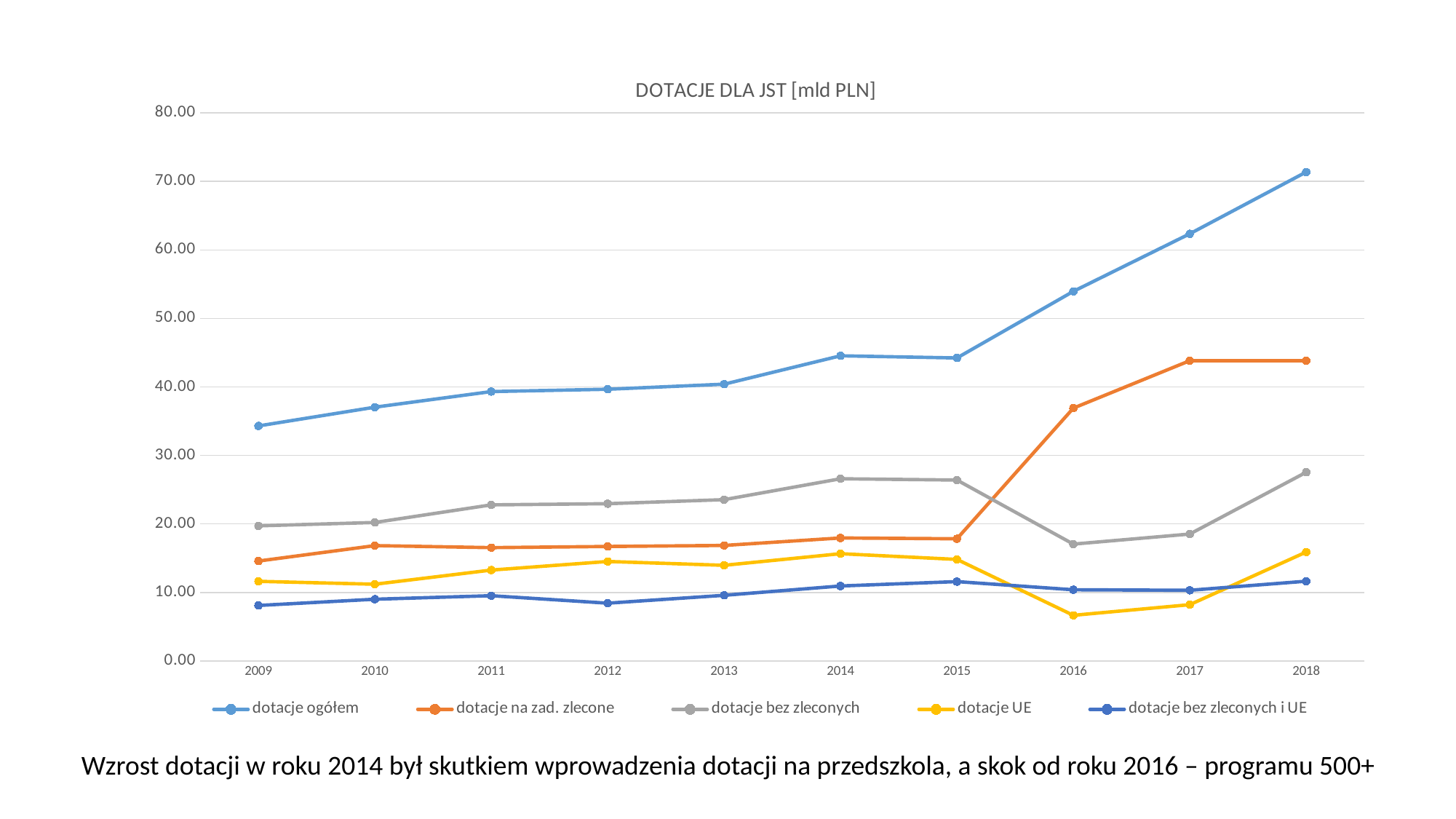
Is the value for 'dotacje UE' in 2016 greater or less than 10.00? less Which colour is used for the 'dotacje UE' series? yellow Does 'dotacje ogółem' generally rise or fall from 2009 to 2018? rise In which year is 'dotacje UE' lowest? 2016 How many years are plotted along the x axis? 10 What is the title of the chart? DOTACJE DLA JST [mld PLN] Is the value for 'dotacje na zad. zlecone' in 2016 greater or less than 30.00? greater What kind of chart is shown on the slide? line chart Is the value for 'dotacje ogółem' in 2018 greater or less than 70.00? greater How many series does the legend list? 5 In 2016, which is larger: 'dotacje na zad. zlecone' or 'dotacje bez zleconych'? dotacje na zad. zlecone In which year is 'dotacje ogółem' highest? 2018